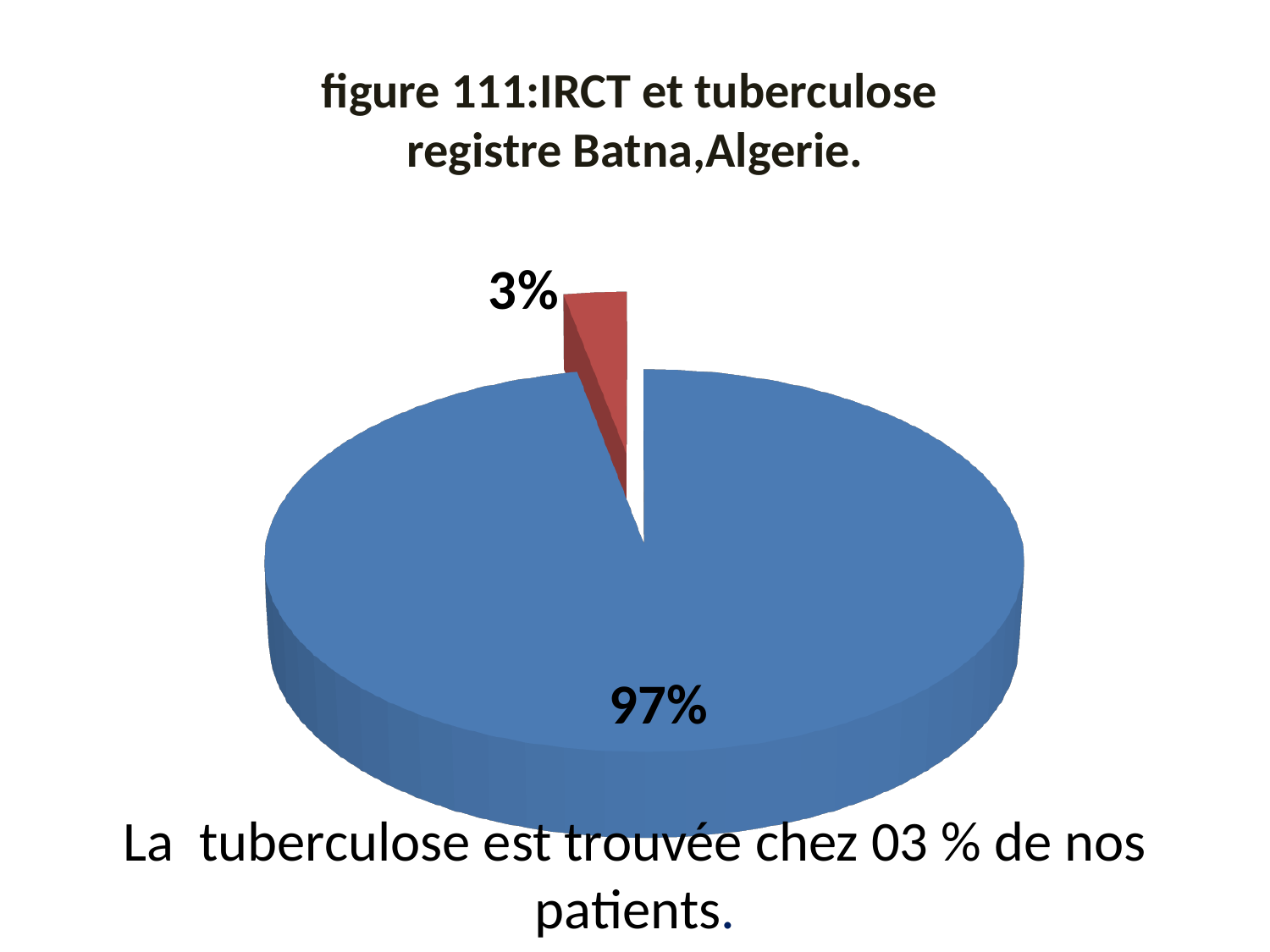
How many slices does the pie chart have? 2 What percentage is shown on the blue slice of the pie chart? 97% What kind of chart is shown on the slide? pie chart What percentage is shown on the red slice of the pie chart? 3% What is the title of the chart? figure 111:IRCT et tuberculose registre Batna,Algerie. Which slice of the pie chart is the smallest? the red slice (3%) Which slice of the pie chart is the largest? the blue slice (97%) What colour is the slice representing 97%? blue Which is larger, the red slice or the blue slice? the blue slice By how many percentage points does the blue slice exceed the red slice? 94 According to the slide, what share of patients were found to have tuberculosis? 3%